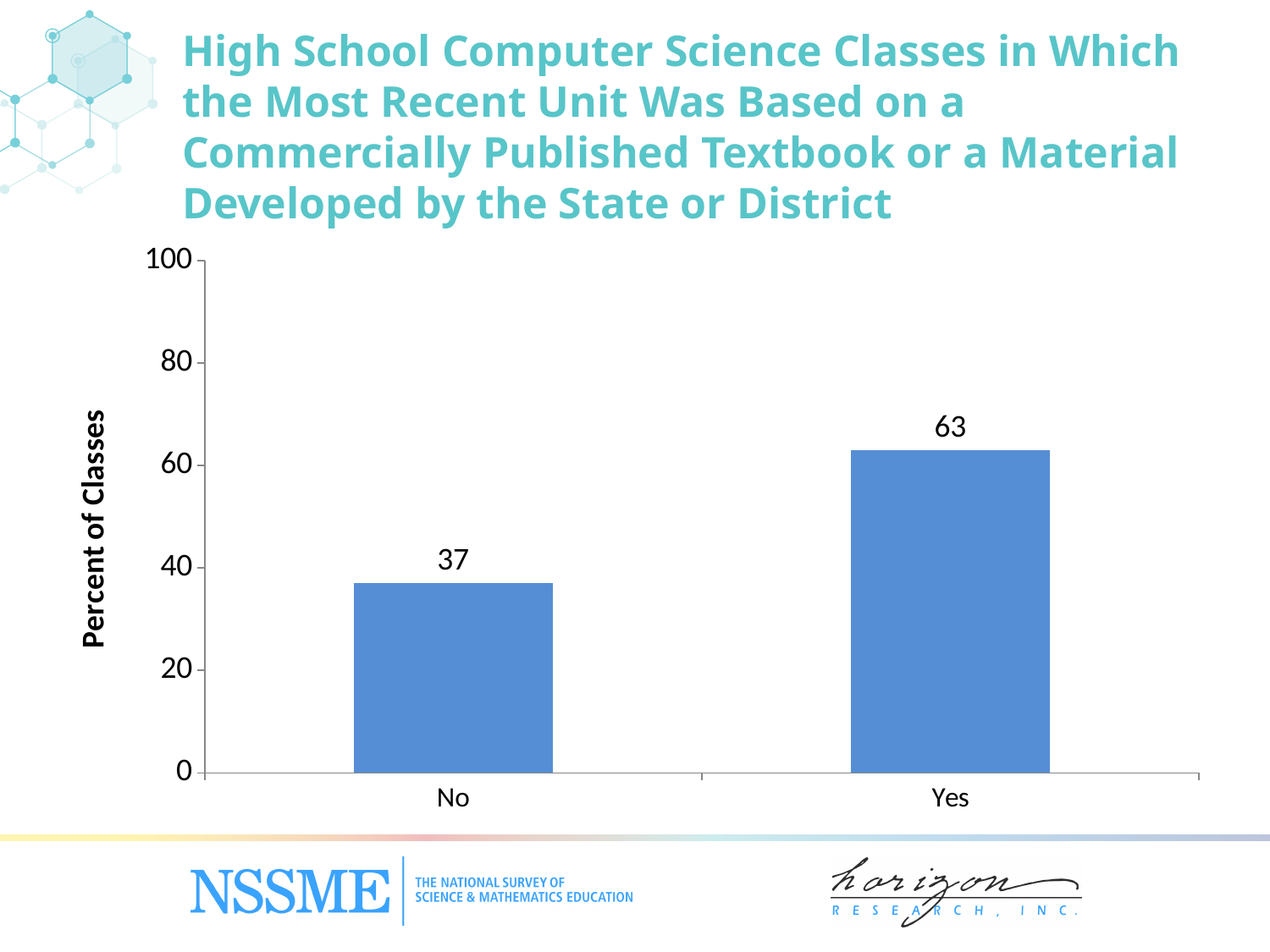
What is the value for the "Yes" category? 63 What is the value for the "No" category? 37 Which category has the lowest value? No Is the value for "Yes" greater or less than 60? greater How many categories are shown on the x axis? 2 Is the value for "No" greater or less than 40? less What is the difference between the values for "Yes" and "No"? 26 What is the maximum value shown on the y axis? 100 What kind of chart is shown on the slide? bar chart What is the label of the y axis? Percent of Classes Which category has the highest value? Yes Which is larger, the value for "No" or the value for "Yes"? Yes